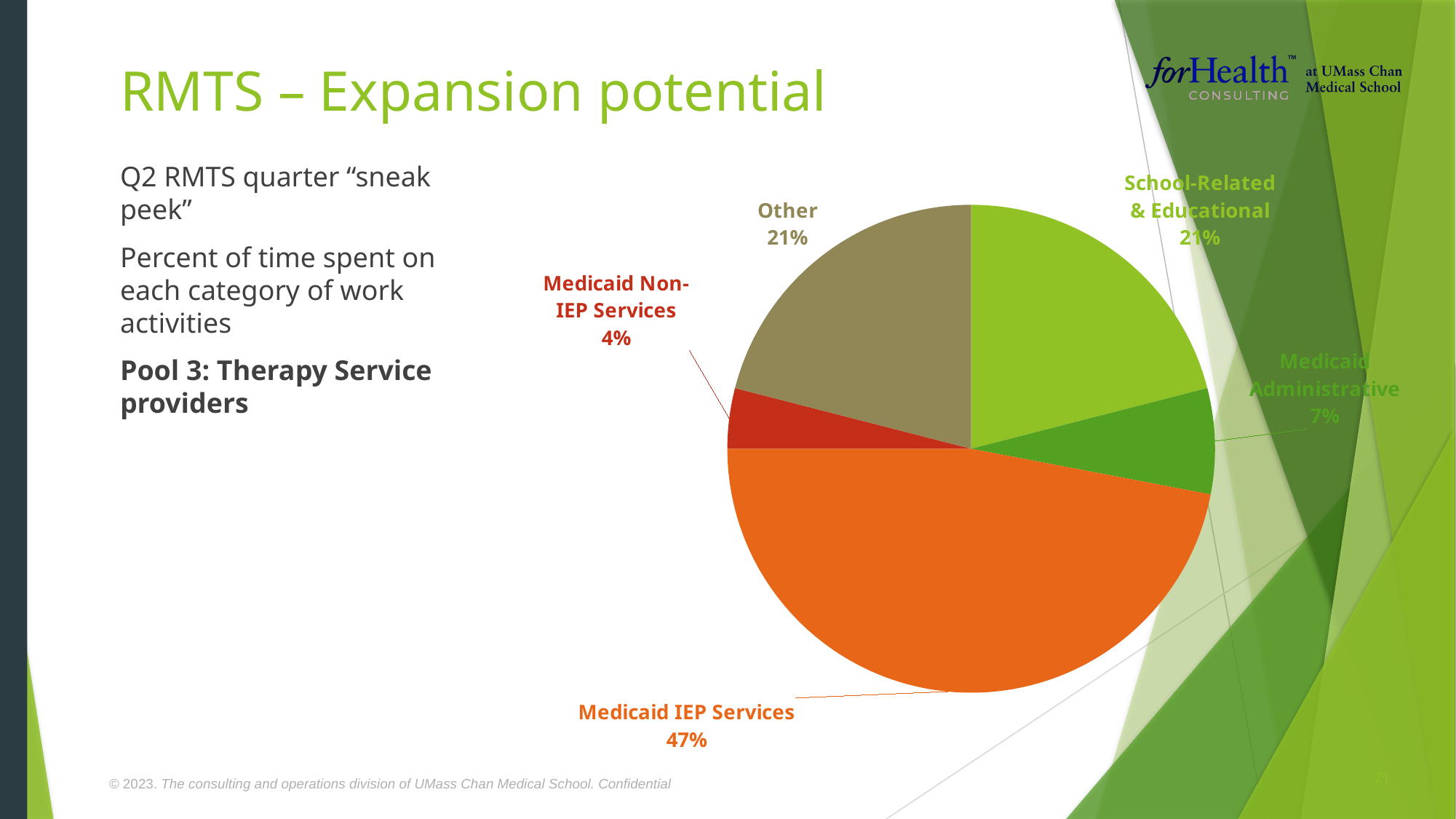
How many categories are shown in the pie chart? 5 What percentage of time is spent on Medicaid Non-IEP Services? 4% What percentage of time is spent on Other activities? 21% What percentage of time is spent on School-Related & Educational activities? 21% Which category has the smallest share of the pie? Medicaid Non-IEP Services Which pool of providers does the chart describe? Pool 3: Therapy Service providers What percentage of time is spent on Medicaid IEP Services? 47% What percentage of time is spent on Medicaid Administrative activities? 7% Which category has the largest share of the pie? Medicaid IEP Services What is the difference in percentage points between Medicaid IEP Services and Other? 26 What kind of chart is shown on the slide? pie chart Which is larger, the share for Medicaid Administrative or the share for Medicaid Non-IEP Services? Medicaid Administrative